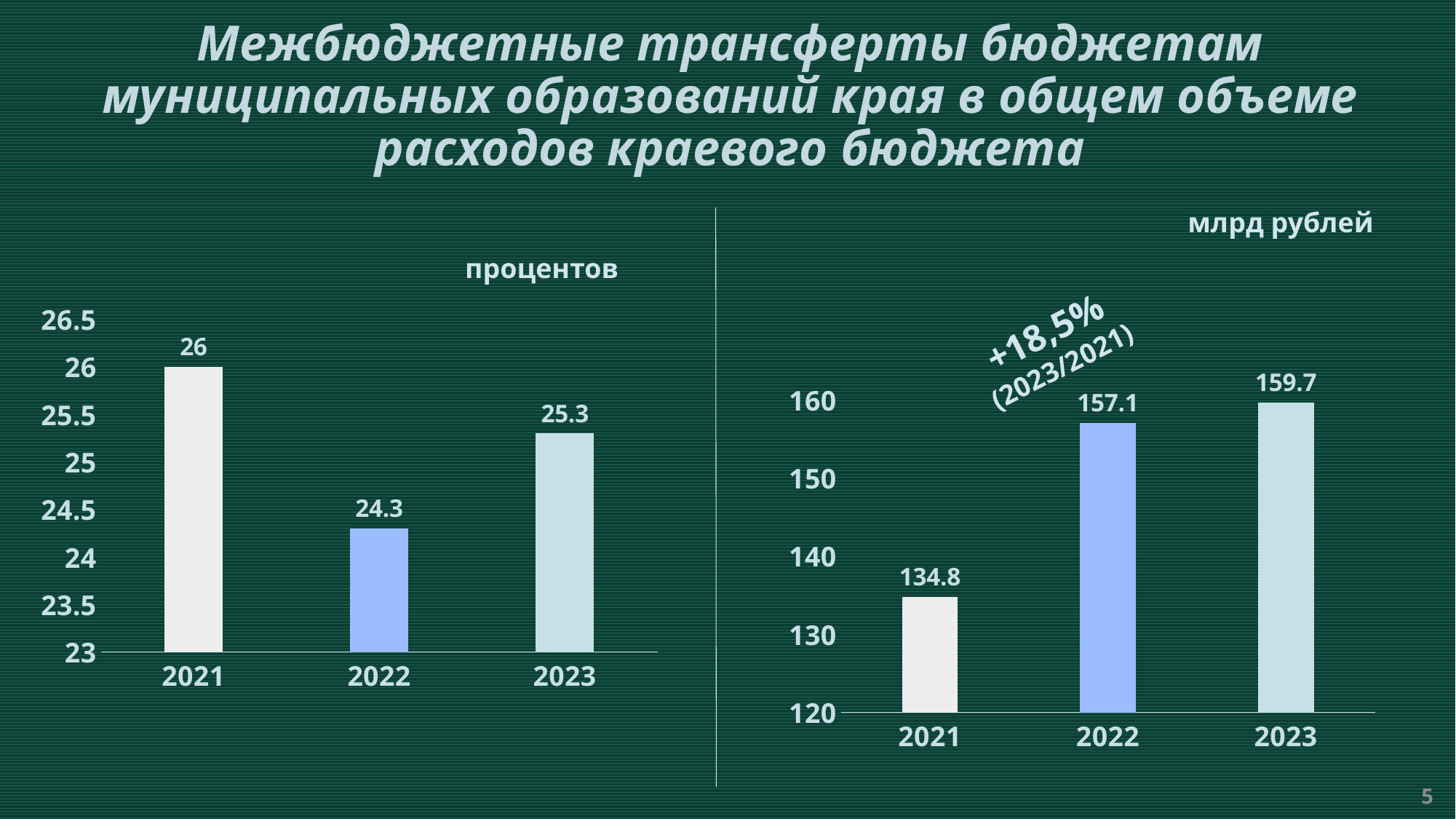
What type of chart is the left chart (процентов)? bar chart In the right chart (млрд рублей), what is the value for 2021? 134.8 In the left chart (процентов), what is the value for 2021? 26 In the right chart (млрд рублей), what is the difference between the 2022 and 2021 values? 22.3 In the right chart (млрд рублей), is the value for 2021 greater or less than 140? less In the left chart (процентов), which is larger, the value for 2021 or the value for 2023? 2021 In the left chart (процентов), what is the value for 2022? 24.3 In the right chart (млрд рублей), which year has the highest value? 2023 In the left chart (процентов), which year has the lowest value? 2022 In the right chart (млрд рублей), what is the value for 2023? 159.7 How many bars are in the right chart (млрд рублей)? 3 In the left chart (процентов), what is the difference between the 2021 and 2023 values? 0.7